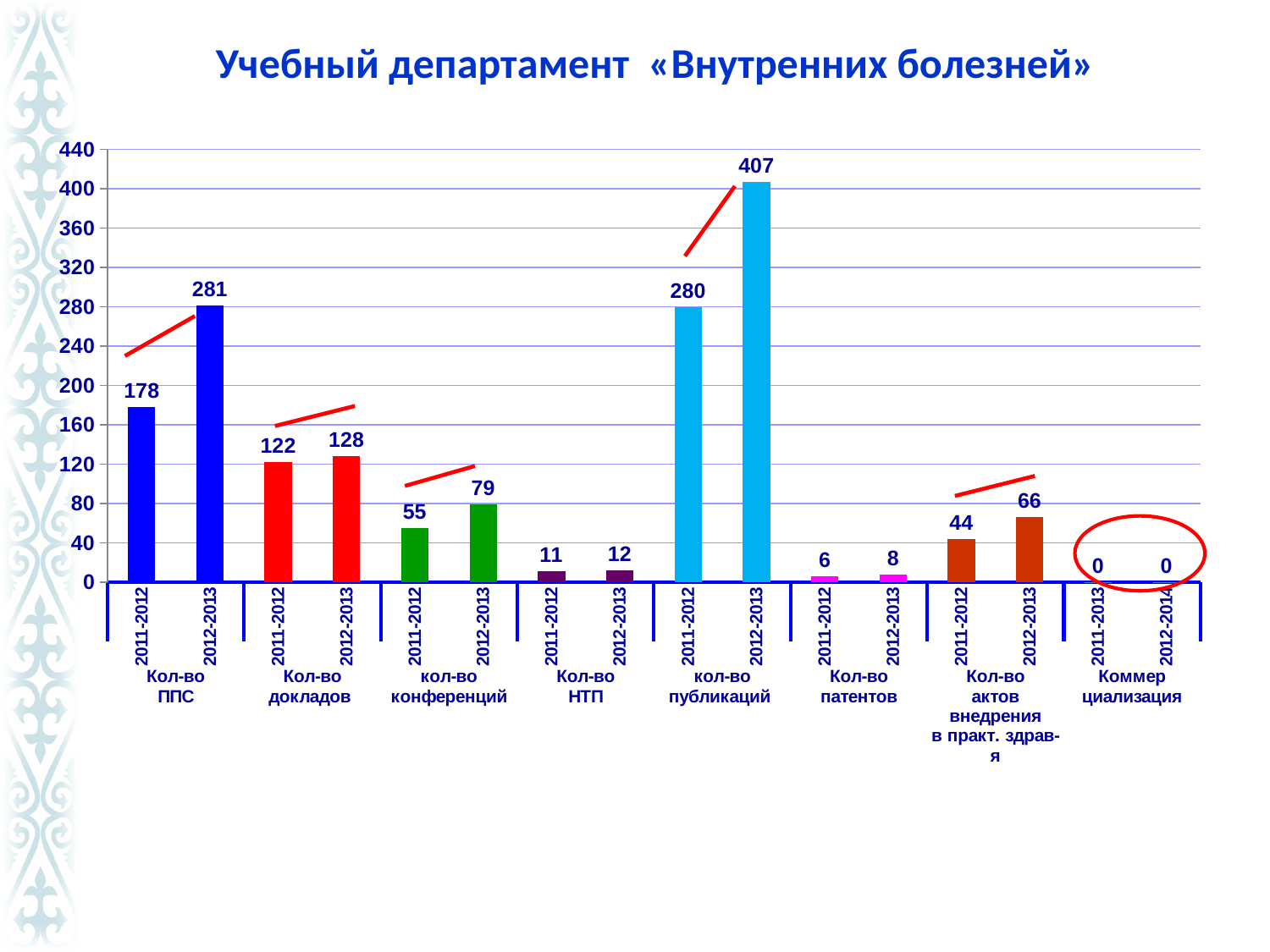
What is the title of the slide? Учебный департамент «Внутренних болезней» Which category has the lowest values on the chart? Коммерциализация What is the value for Кол-во патентов in 2012-2013? 8 How many categories (groups) are shown along the x axis? 8 What is the difference between the 2012-2013 and 2011-2012 values for Кол-во ППС? 103 Which is larger: Кол-во докладов in 2012-2013 or Кол-во ППС in 2011-2012? Кол-во ППС in 2011-2012 What is the value for кол-во конференций in 2011-2012? 55 Which bar has the highest value on the chart? кол-во публикаций, 2012-2013 (407) What is the difference between the 2012-2013 and 2011-2012 values for кол-во публикаций? 127 What is the value for кол-во публикаций in 2011-2012? 280 What kind of chart is shown on the slide? Bar chart What is the value for Кол-во ППС in 2012-2013? 281